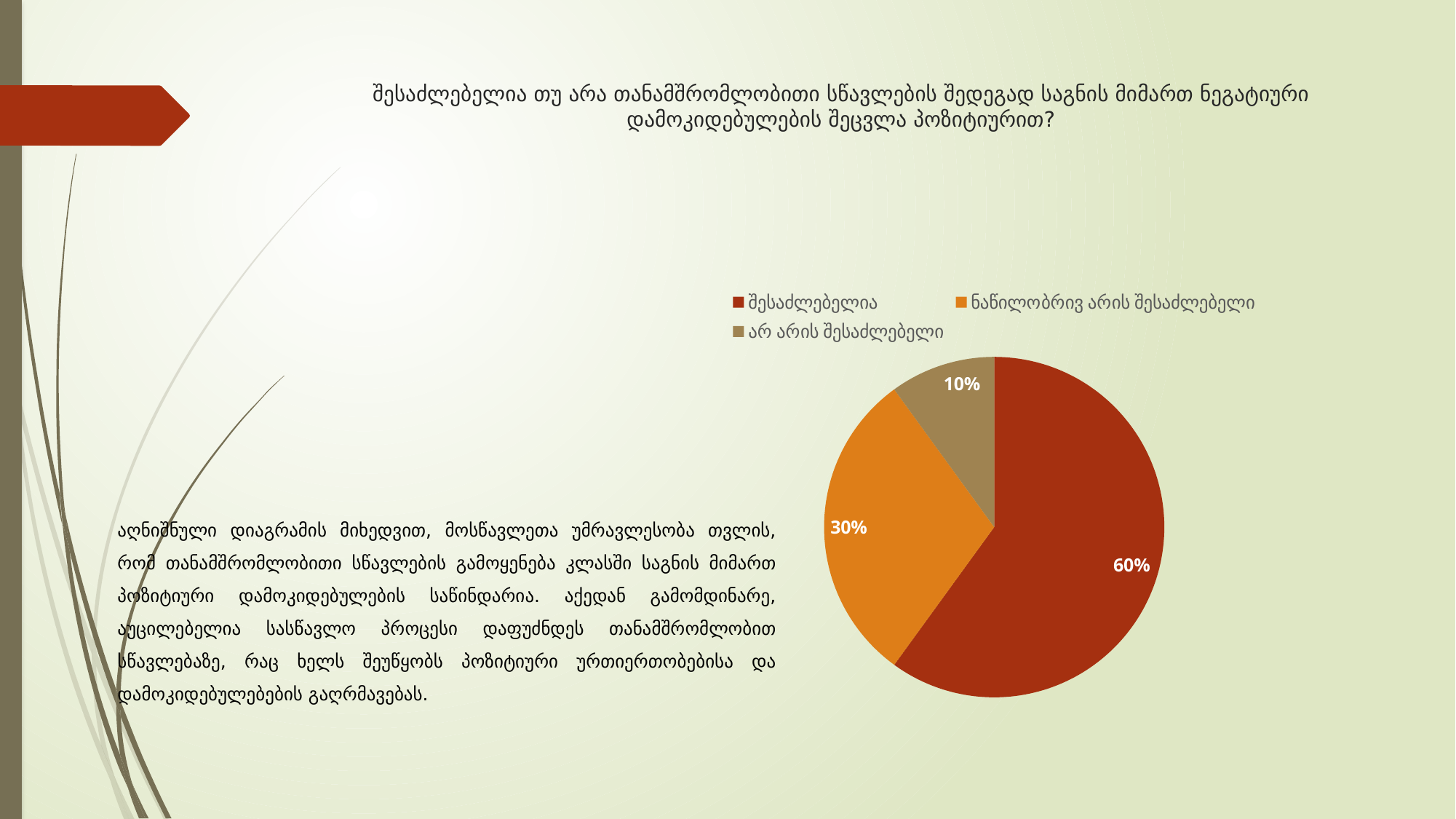
What percentage is shown for the slice "არ არის შესაძლებელი"? 10% What is the difference in percentage points between the "შესაძლებელია" slice and the "ნაწილობრივ არის შესაძლებელი" slice? 30 percentage points What percentage of the pie is labelled for the slice "შესაძლებელია"? 60% Which slice is larger: "ნაწილობრივ არის შესაძლებელი" or "არ არის შესაძლებელი"? ნაწილობრივ არის შესაძლებელი How many slices does the pie chart have? 3 What share of the pie does the "შესაძლებელია" slice represent? 60% Which category has the largest slice of the pie? შესაძლებელია How many entries does the legend list? 3 Which category has the smallest slice of the pie? არ არის შესაძლებელი What kind of chart is shown on the slide? pie chart What percentage is shown for the slice "ნაწილობრივ არის შესაძლებელი"? 30% What colour is the slice for "ნაწილობრივ არის შესაძლებელი"? orange